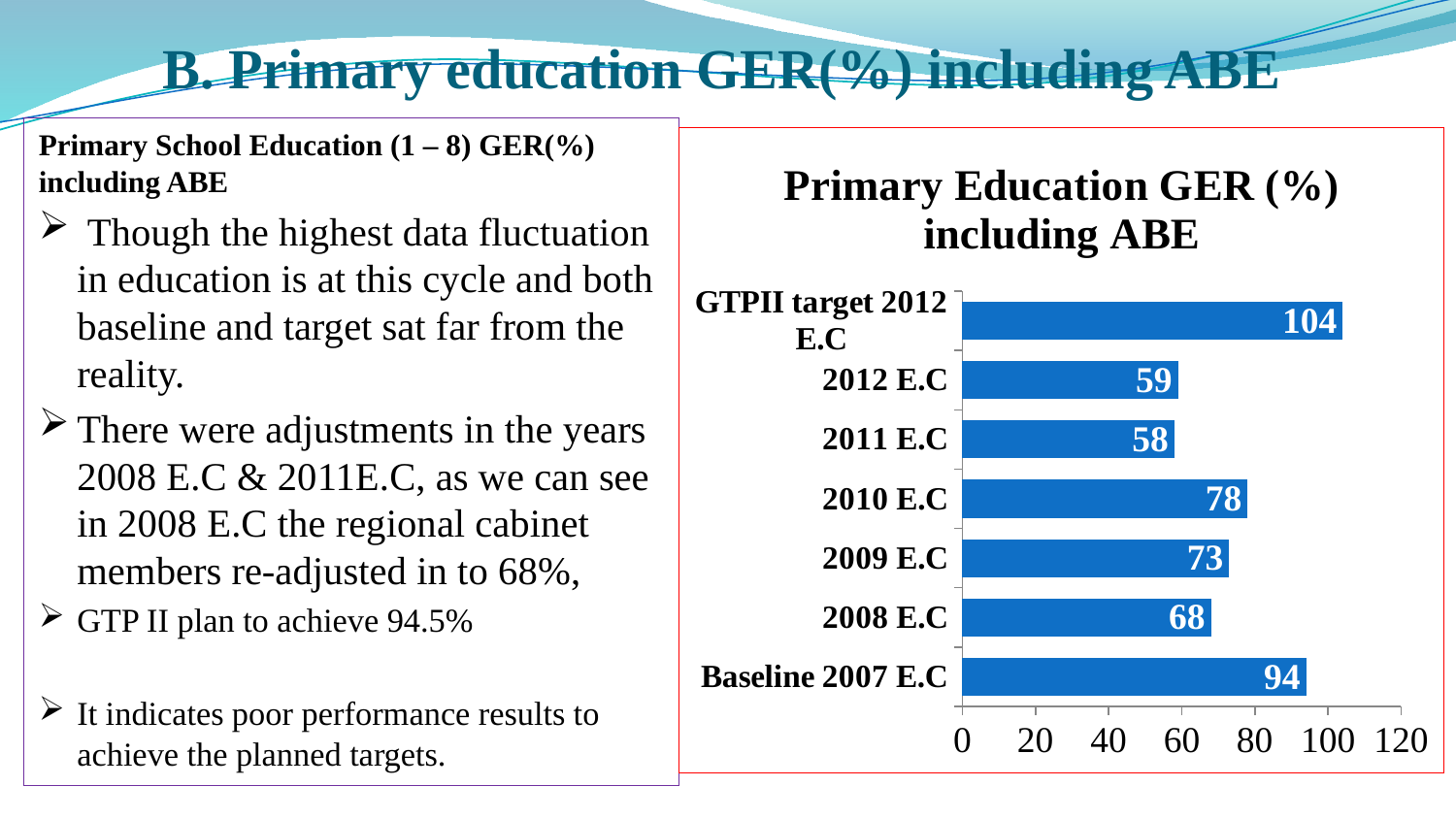
Which category has the lowest value? 2011 E.C What is the difference between the GTPII target 2012 E.C value and the 2012 E.C value? 45 How many categories are shown in the chart? 7 Is the value for 2008 E.C greater or less than 80? less Which is larger, the value for 2009 E.C or the value for 2010 E.C? 2010 E.C What is the value for GTPII target 2012 E.C? 104 Which category has the highest value? GTPII target 2012 E.C What is the value for Baseline 2007 E.C? 94 What kind of chart is shown on the slide? bar chart What is the title of the chart? Primary Education GER (%) including ABE What is the value for 2010 E.C? 78 What is the difference between the Baseline 2007 E.C value and the 2008 E.C value? 26